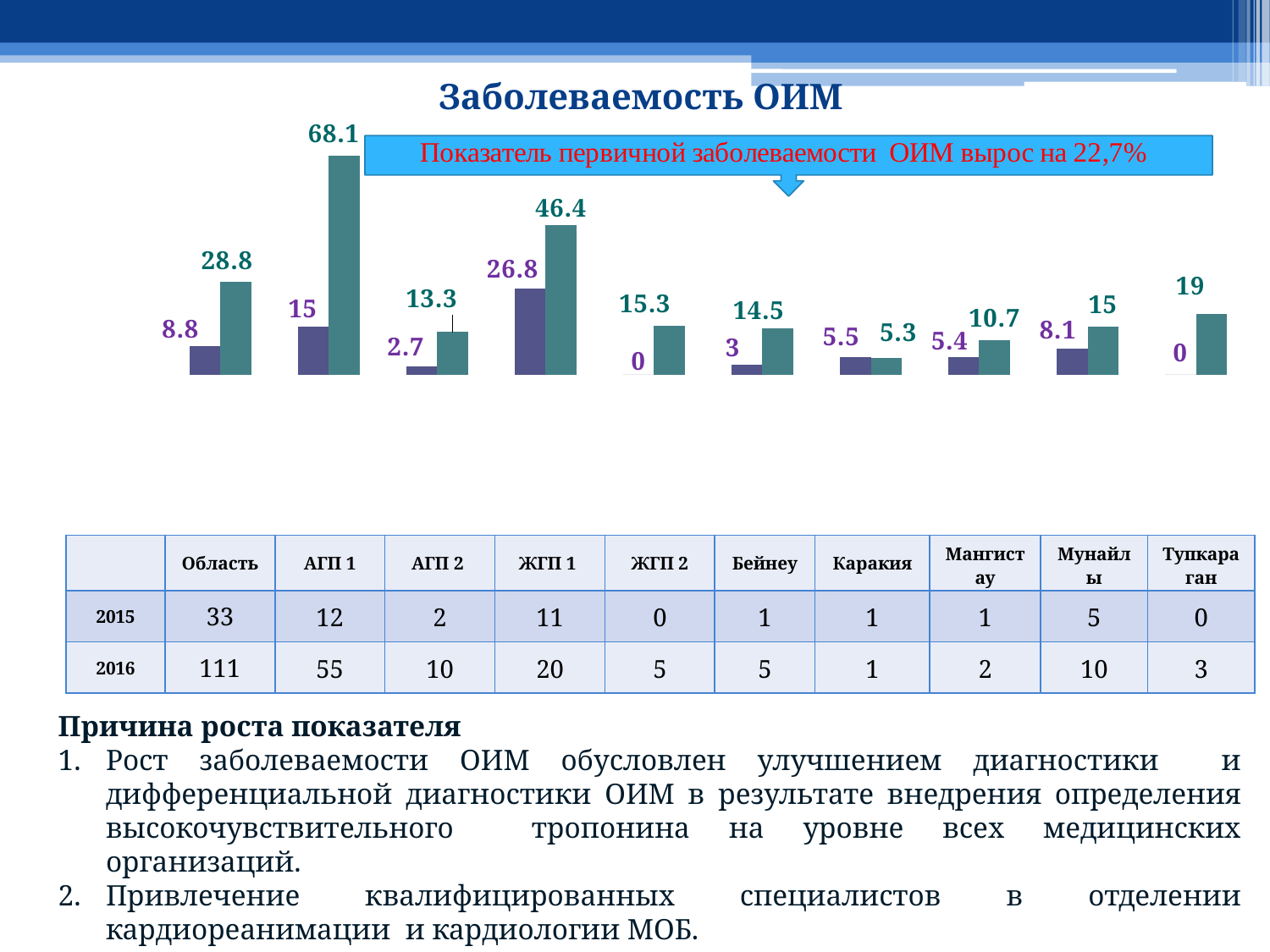
What is the value of the teal bar in the fourth group from the left (aligned with the ЖГП 1 column)? 46.4 What is the value of the purple bar in the first group from the left (aligned with the Область column)? 8.8 In the seventh group from the left (aligned with Каракия), which bar is larger, the purple one (5.5) or the teal one (5.3)? purple (5.5) What is the title of the chart? Заболеваемость ОИМ What is the highest value labelled on any teal bar in the chart? 68.1 In the first group from the left, what is the difference between the teal bar (28.8) and the purple bar (8.8)? 20 According to the text box on the chart, by what percentage did the primary incidence rate of ОИМ grow? 22,7% What is the lowest value labelled on a teal bar in the chart? 5.3 How many bars are there in each group of the chart? 2 How many groups of bars does the chart contain? 10 What kind of chart is shown at the top of the slide? bar chart In the second group from the left (aligned with АГП 1), what is the difference between the teal bar (68.1) and the purple bar (15)? 53.1